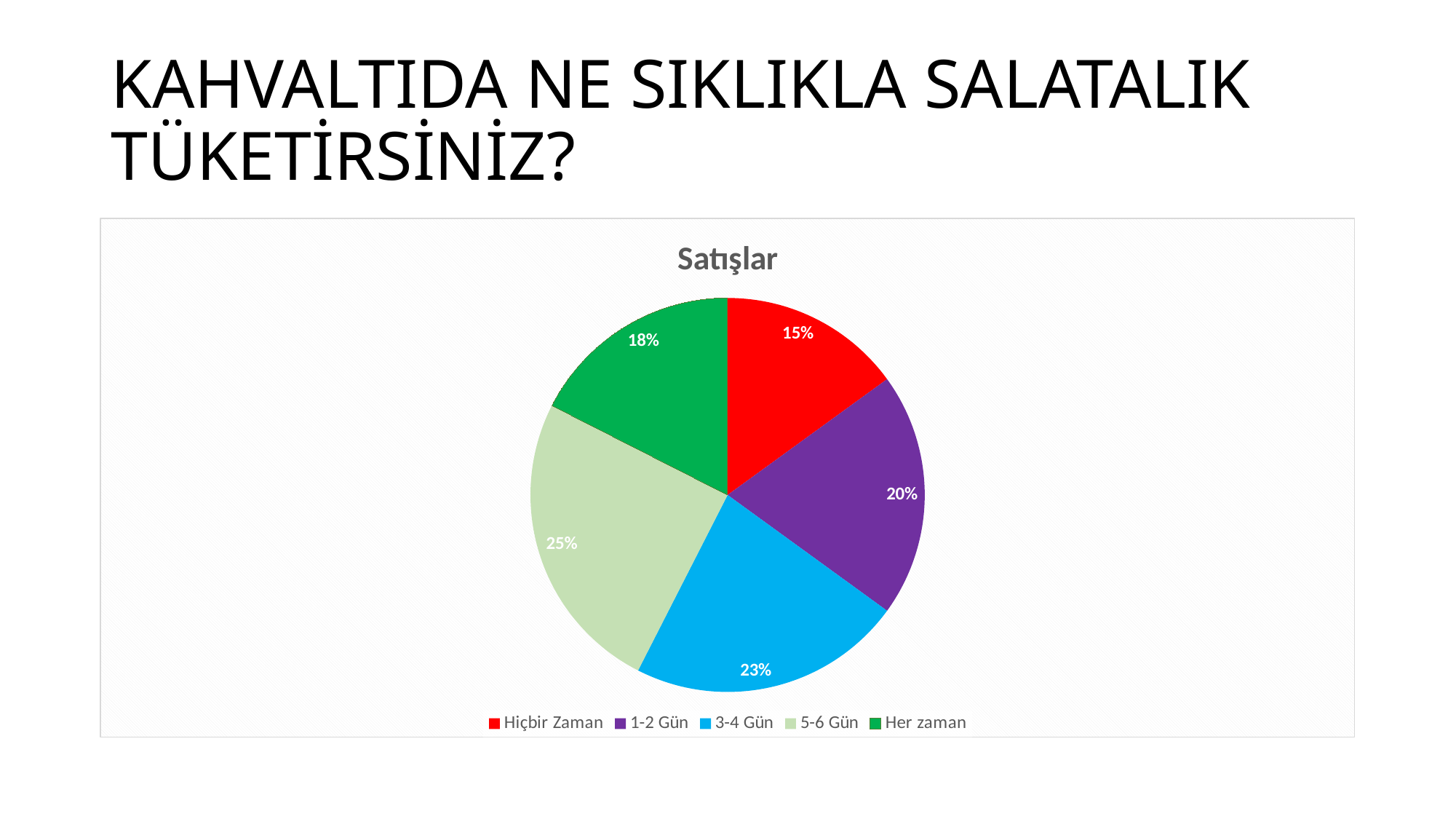
What is the title of the chart? Satışlar What share of the pie does the '5-6 Gün' slice represent? 25% Which category has the largest slice of the pie? 5-6 Gün Which is larger, the '3-4 Gün' slice or the 'Her zaman' slice? 3-4 Gün What share of the pie does the 'Hiçbir Zaman' slice represent? 15% Which category has the smallest slice of the pie? Hiçbir Zaman What share of the pie does the '3-4 Gün' slice represent? 23% What type of chart is shown on the slide? pie chart How many categories does the pie chart show? 5 What is the difference in percentage points between the '5-6 Gün' slice and the 'Hiçbir Zaman' slice? 10